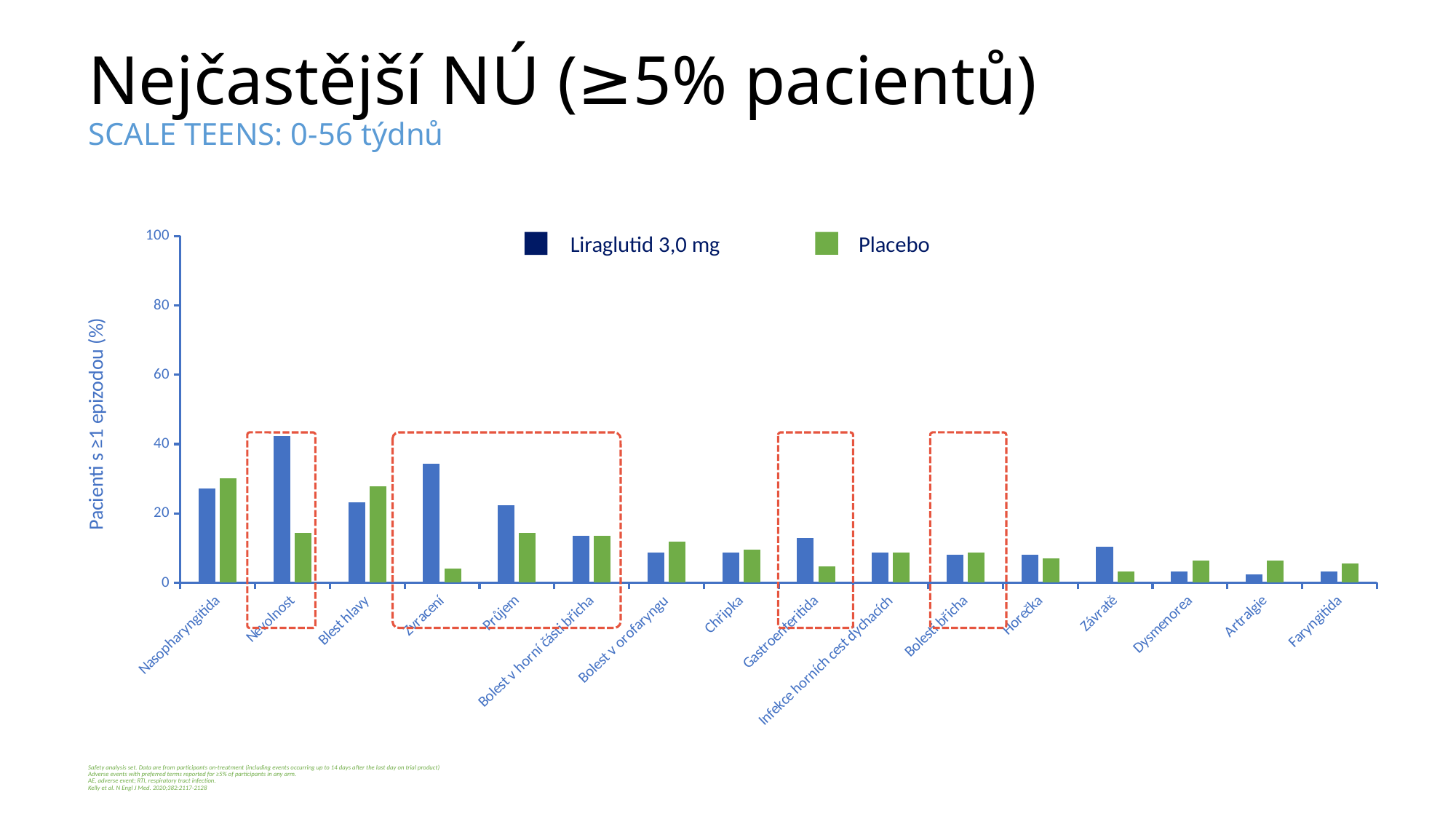
What are the two series named in the legend? Liraglutid 3,0 mg and Placebo What is the label of the y axis? Pacienti s ≥1 epizodou (%) How many series does the legend list? 2 What kind of chart is shown on the slide? bar chart For Závratě, which series has the larger value, Liraglutid 3,0 mg or Placebo? Liraglutid 3,0 mg Is the Placebo value for Zvracení greater or less than 20? less Is the Liraglutid 3,0 mg value for Zvracení greater or less than 20? greater How many adverse event categories are shown on the x axis? 16 Which category has the highest value for Liraglutid 3,0 mg? Nevolnost For Nasopharyngitida, which series has the larger value, Liraglutid 3,0 mg or Placebo? Placebo Is the Liraglutid 3,0 mg value for Průjem greater or less than 40? less